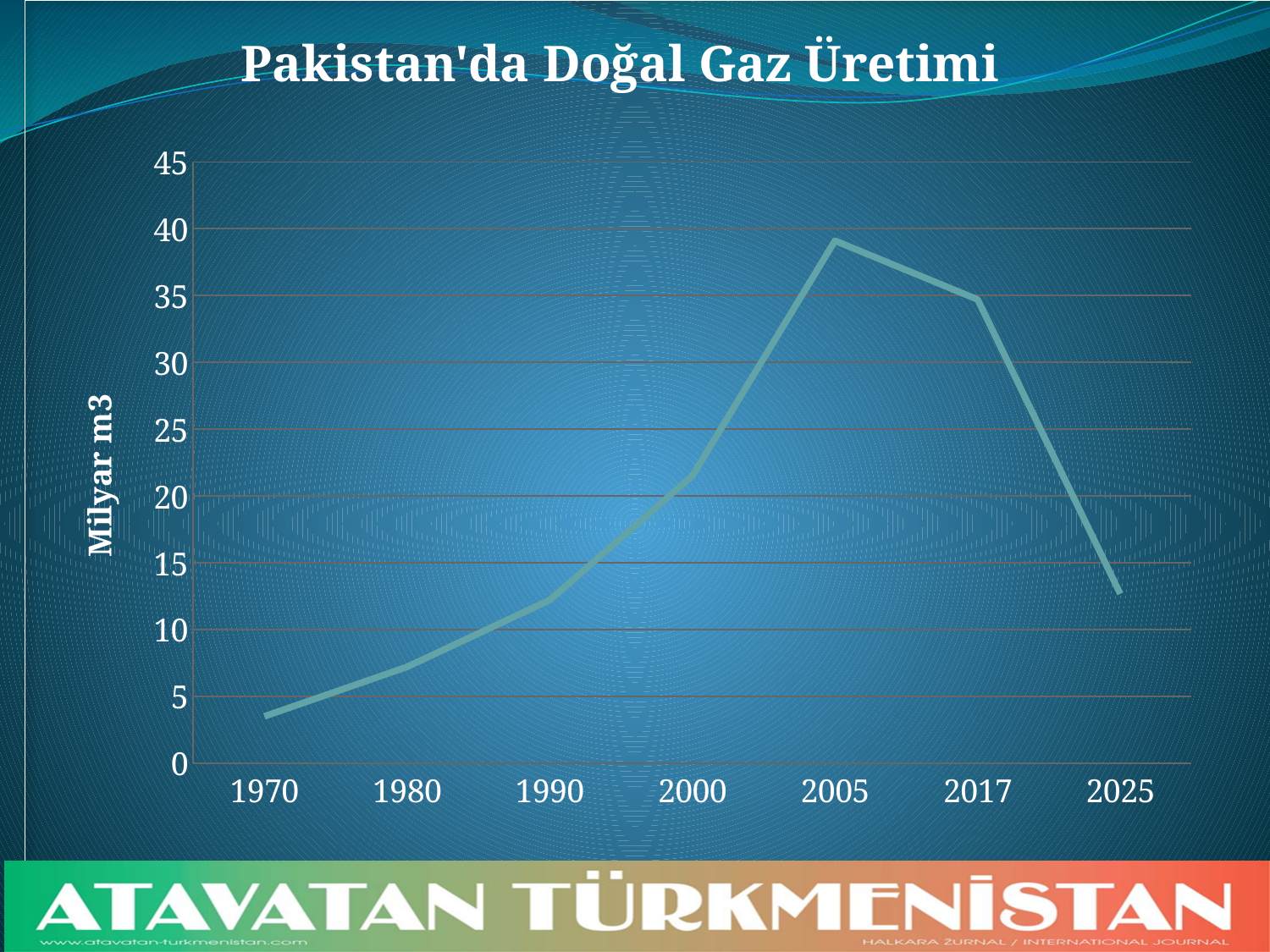
Which year has the highest natural gas production value in the chart? 2005 Which year has the larger value, 2005 or 2017? 2005 What kind of chart is shown on the slide? line chart Do the values rise or fall from 1970 to 2005? rise Is the value for 2005 greater or less than 35? greater What is the title of the chart? Pakistan'da Doğal Gaz Üretimi What is the label on the vertical axis of the chart? Milyar m3 Is the value for 2000 greater or less than 20? greater Is the value for 1970 greater or less than 5? less How many years are plotted along the x axis of the chart? 7 Which year has the lowest natural gas production value in the chart? 1970